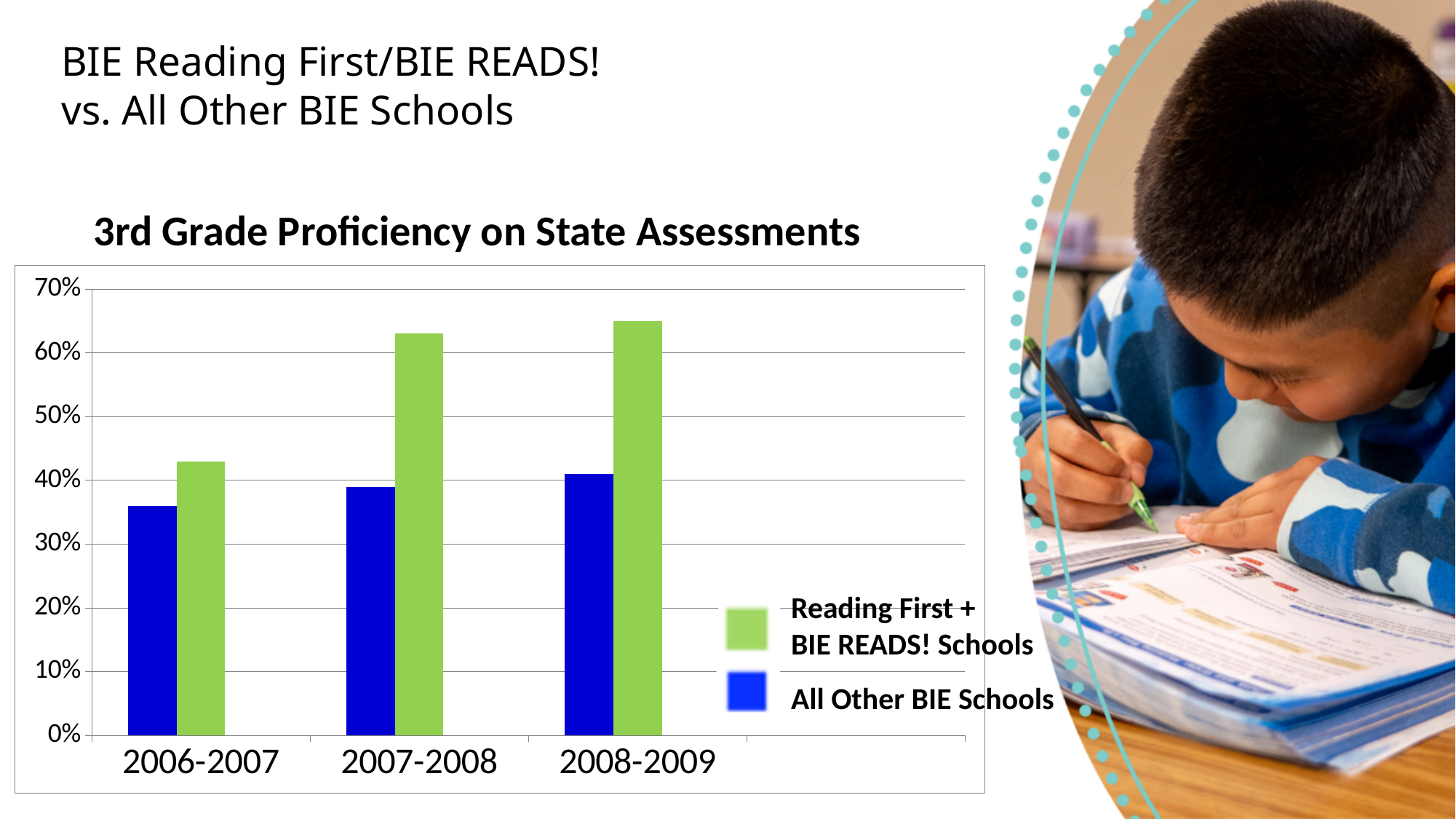
Which series is shown in green? Reading First + BIE READS! Schools How many series does the legend list? 2 In which school year is the value for All Other BIE Schools lowest? 2006-2007 Is the value for All Other BIE Schools in 2006-2007 greater or less than 40%? less Is the value for Reading First + BIE READS! Schools in 2006-2007 greater or less than 40%? greater Do the values for Reading First + BIE READS! Schools rise or fall from 2006-2007 to 2008-2009? rise Is the value for Reading First + BIE READS! Schools in 2007-2008 greater or less than 60%? greater What is the title of the chart? 3rd Grade Proficiency on State Assessments How many school-year categories are shown on the x axis? 3 What kind of chart is shown on the slide? bar chart In 2008-2009, which series has the higher value: Reading First + BIE READS! Schools or All Other BIE Schools? Reading First + BIE READS! Schools